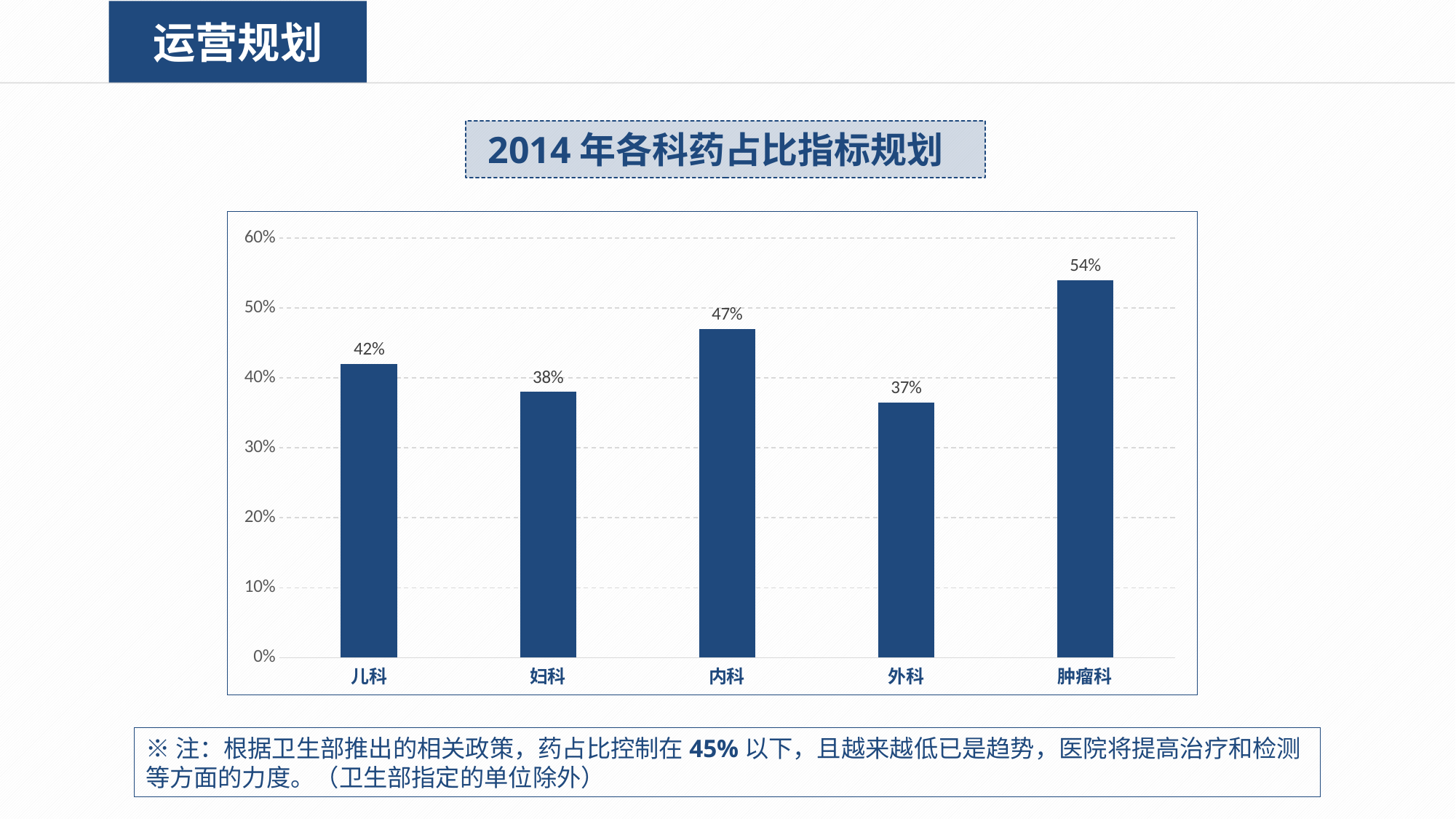
What is the value for 肿瘤科? 54% Which category has the lowest value? 外科 Which is larger, the value for 内科 or the value for 儿科? 内科 Is the value for 内科 greater or less than 40%? greater How many categories are shown on the x axis? 5 What kind of chart is shown on the slide? bar chart Which category has the highest value? 肿瘤科 What is the value for 外科? 37% What is the difference between the values for 儿科 and 妇科? 4% What is the difference between the values for 肿瘤科 and 内科? 7% What is the value for 儿科? 42% What is the title of the chart? 2014 年各科药占比指标规划